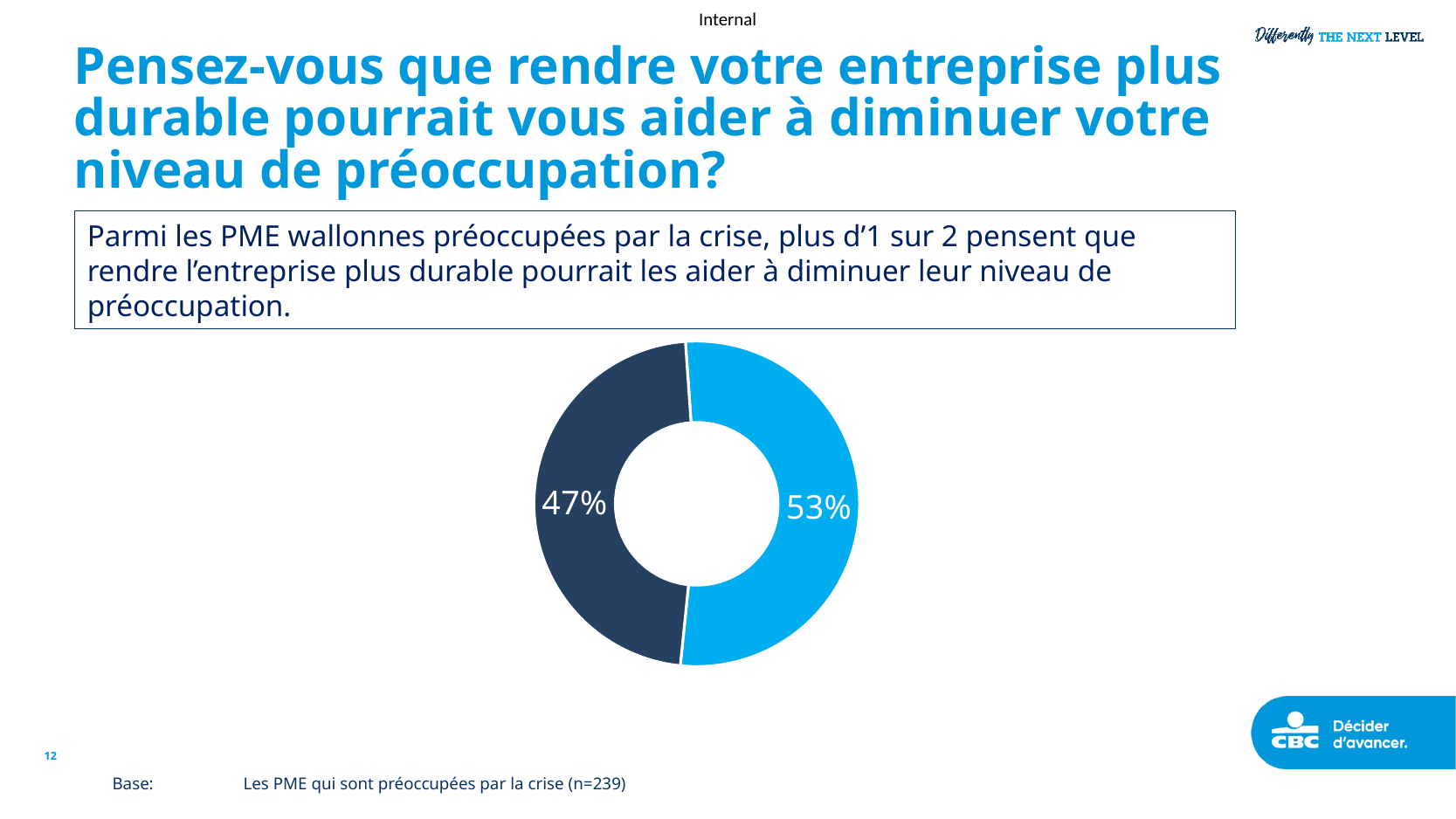
Which slice of the donut chart is the largest? The light blue slice (53%) What is the difference in percentage points between the two slices of the donut chart? 6 percentage points What value is shown on the light blue slice of the donut chart? 53% What do the two slices of the donut chart add up to? 100% Which slice of the donut chart is the smallest? The dark blue slice (47%) What share of the donut chart does the dark blue slice represent? 47% Is the light blue slice larger or smaller than the dark blue slice? Larger What value is shown on the dark blue slice of the donut chart? 47% How many slices does the donut chart have? 2 What is the base (sample size) stated for the chart on the slide? Les PME qui sont préoccupées par la crise (n=239) What kind of chart is shown on the slide? Donut (pie) chart Is the value of the light blue slice greater or less than 50%? greater